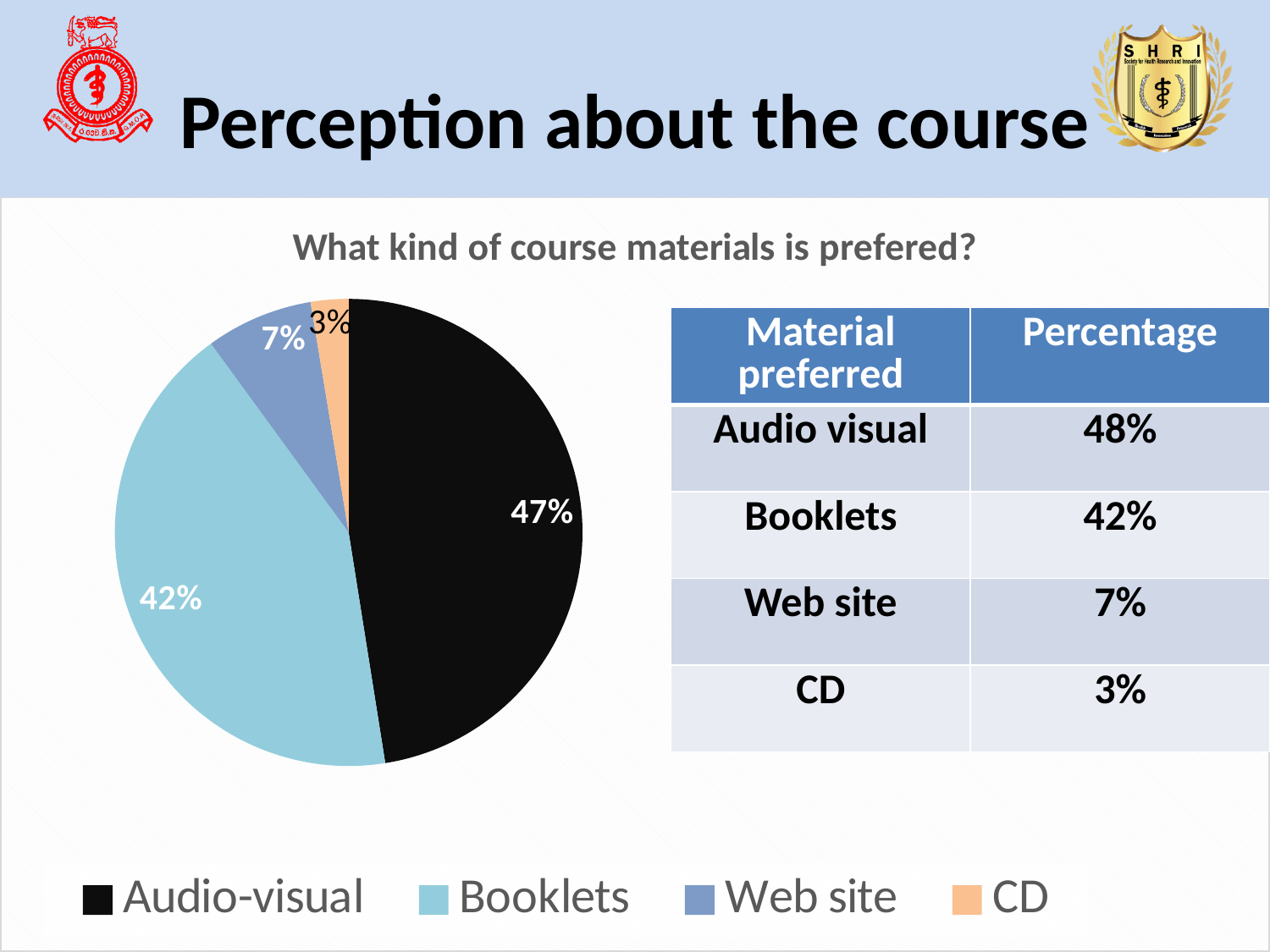
Which is larger in the pie chart, Web site or CD? Web site What percentage does the Audio-visual slice show in the pie chart? 47% How many categories does the pie chart show? 4 Which category has the largest slice in the pie chart? Audio-visual What is the title of the chart? What kind of course materials is prefered? What percentage does the CD slice show in the pie chart? 3% What percentage does the Web site slice show in the pie chart? 7% Which category has the smallest slice in the pie chart? CD What percentage does the Booklets slice show in the pie chart? 42% What type of chart is shown on the slide? pie chart What colour is the Booklets slice in the pie chart? light blue What is the difference between the Audio-visual and Booklets slices in the pie chart? 5%